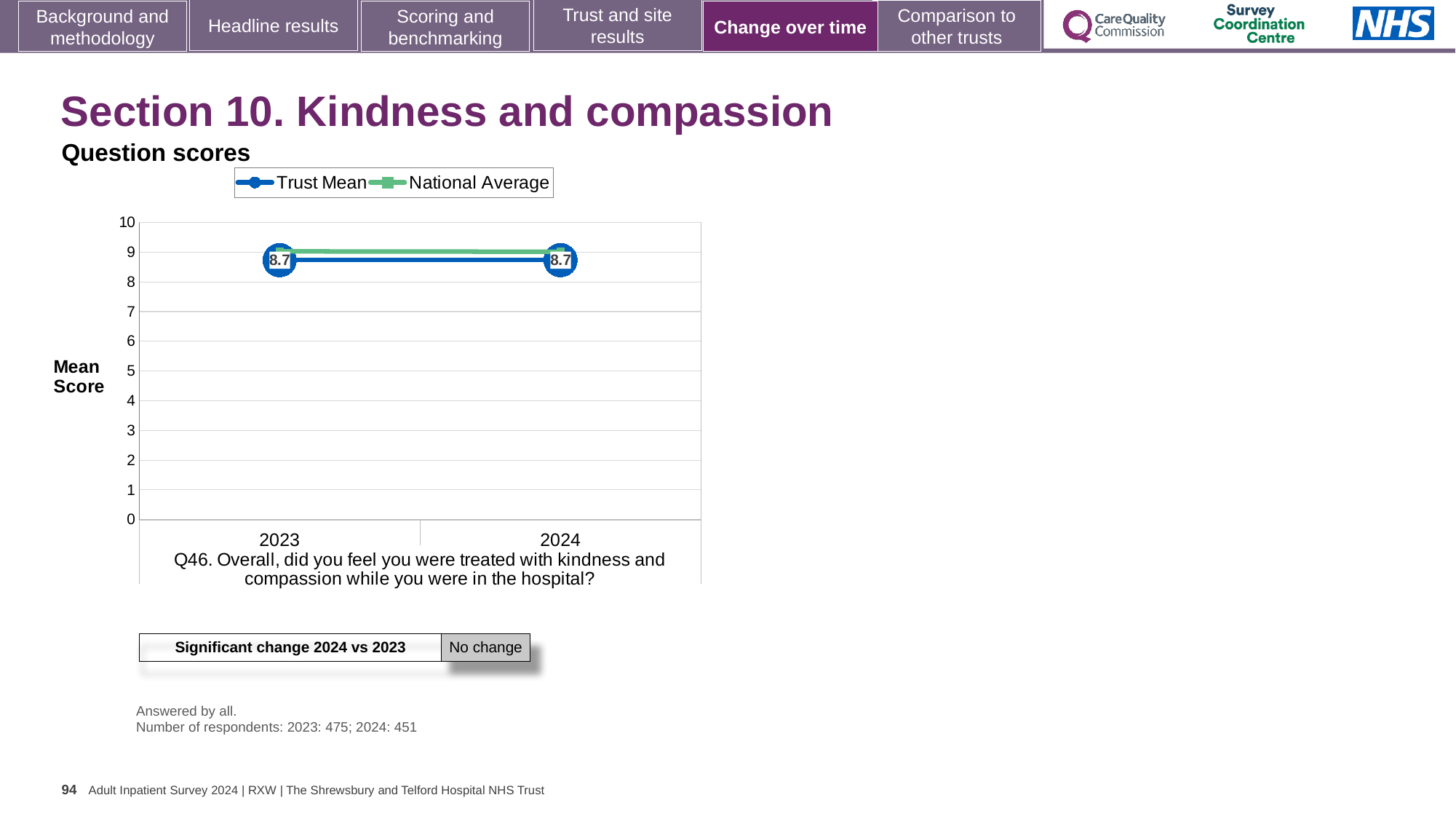
What is the Trust Mean score for 2023? 8.7 What is the label on the y axis of the chart? Mean Score Is the National Average value for 2023 greater or less than 8? greater What is the Trust Mean score for 2024? 8.7 What are the two series named in the chart legend? Trust Mean and National Average What is the difference between the Trust Mean score in 2024 and in 2023? 0 Does the Trust Mean rise, fall or stay the same from 2023 to 2024? Stays the same How many years are plotted on the x axis of the chart? 2 What kind of chart is shown on the slide? Line chart Is the Trust Mean value for 2024 greater or less than 9? less How many series does the chart legend list? 2 In 2024, which is higher: the Trust Mean or the National Average? National Average